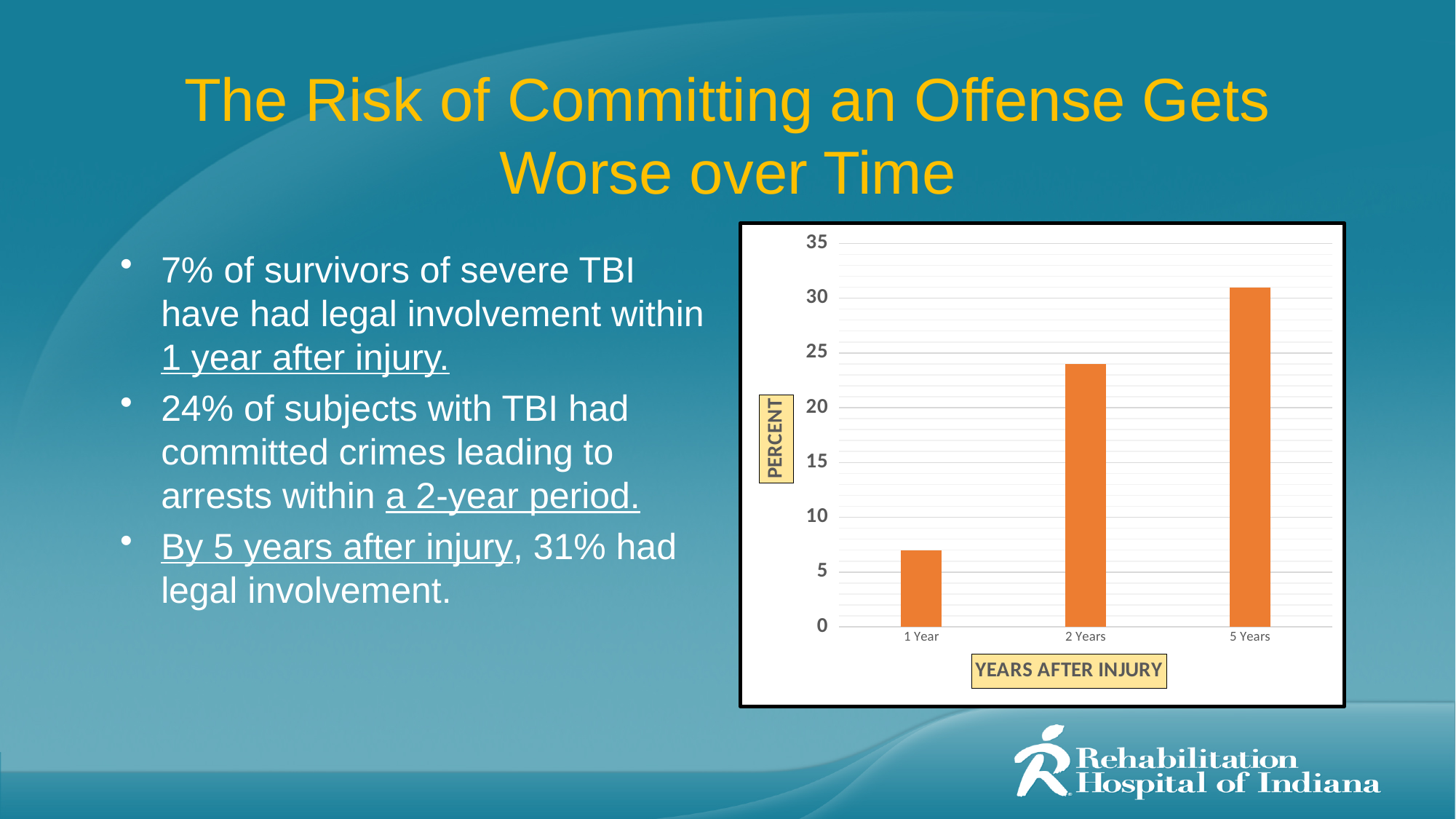
What is the label on the x axis of the chart? YEARS AFTER INJURY Is the value for 5 Years greater or less than 30? greater Which category has the lowest bar in the chart? 1 Year Which is larger, the value for 5 Years or the value for 2 Years? 5 Years Is the bar for 2 Years taller than the bar for 1 Year? Yes Is the value for 1 Year greater or less than 10? less What is the label on the y axis of the chart? PERCENT How many categories are shown on the x axis of the chart? 3 Is the value for 2 Years greater or less than 20? greater What kind of chart is shown on the slide? bar chart Do the values rise or fall as years after injury increase along the x axis? rise Which category has the highest bar in the chart? 5 Years